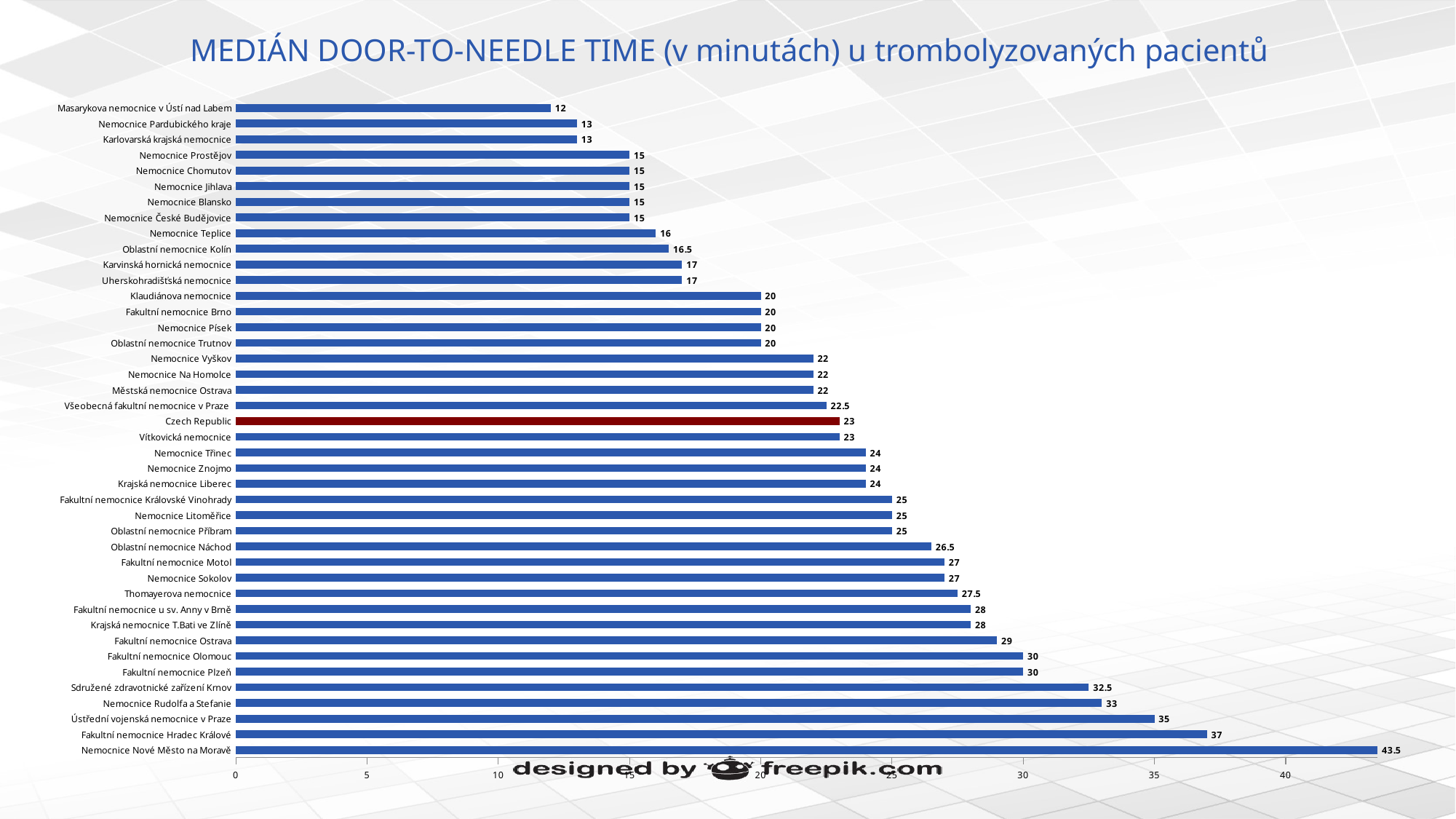
What is the median door-to-needle time for Czech Republic? 23 Which has a larger value, Fakultní nemocnice Hradec Králové or Fakultní nemocnice Plzeň? Fakultní nemocnice Hradec Králové How many hospitals/categories are plotted on the chart? 42 Is the value for Sdružené zdravotnické zařízení Krnov greater or less than 30? greater What is the value shown for Fakultní nemocnice Motol? 27 Which hospital has the highest median door-to-needle time? Nemocnice Nové Město na Moravě Which hospital has the lowest median door-to-needle time? Masarykova nemocnice v Ústí nad Labem Which bar is highlighted in a different colour (dark red) from the others? Czech Republic What is the value shown for Oblastní nemocnice Kolín? 16.5 What is the difference between the values for Ústřední vojenská nemocnice v Praze and Czech Republic? 12 What kind of chart is shown on the slide? bar chart What is the difference between the values for Nemocnice Nové Město na Moravě and Masarykova nemocnice v Ústí nad Labem? 31.5